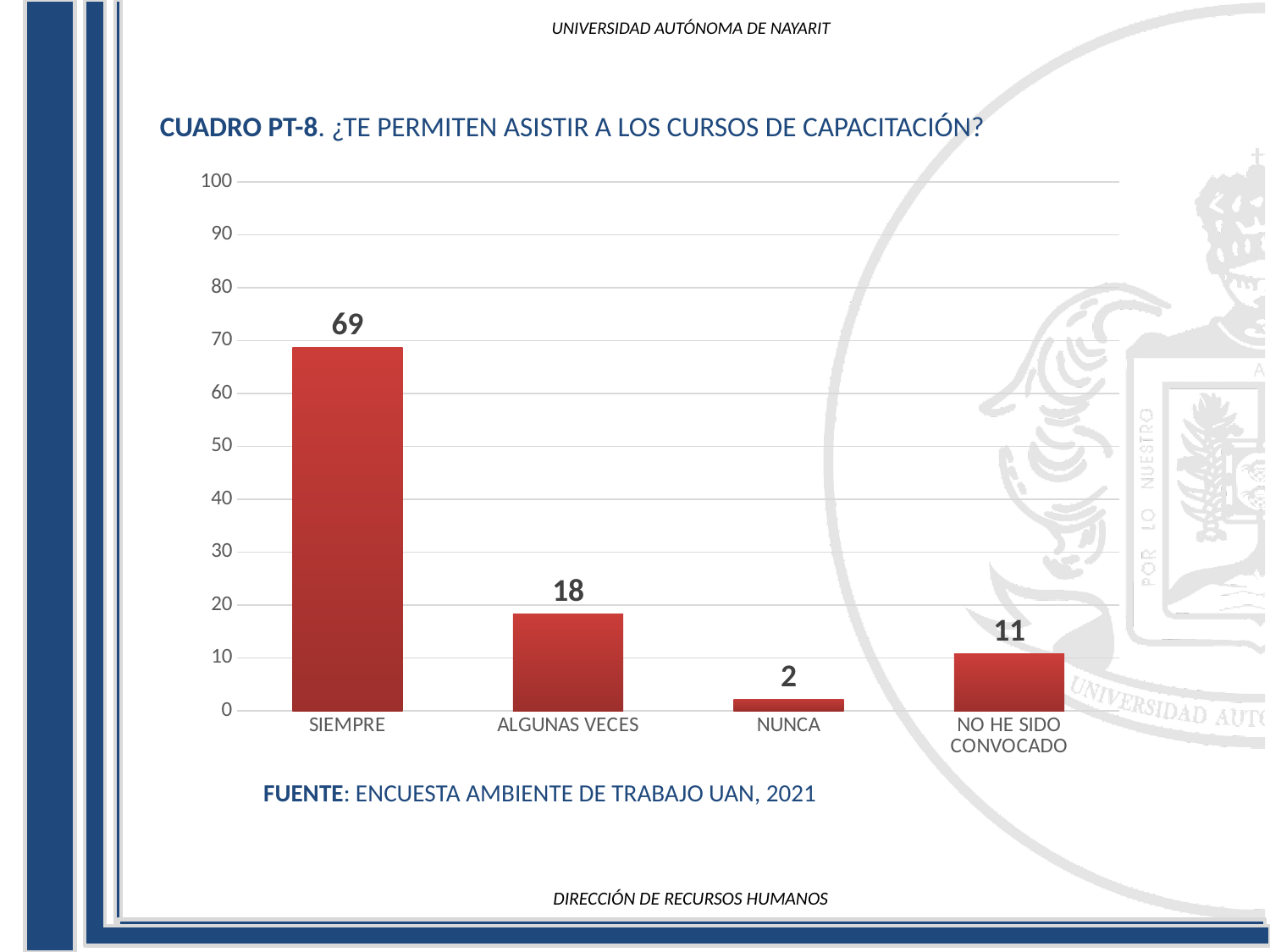
How many categories are shown on the x axis? 4 What is the value for NO HE SIDO CONVOCADO? 11 What is the difference between the values for SIEMPRE and ALGUNAS VECES? 51 Which is larger, the value for NO HE SIDO CONVOCADO or the value for NUNCA? NO HE SIDO CONVOCADO Which category has the highest value? SIEMPRE What is the value for NUNCA? 2 Is the value for SIEMPRE greater or less than 60? greater What is the difference between the values for ALGUNAS VECES and NO HE SIDO CONVOCADO? 7 What is the value for SIEMPRE? 69 What kind of chart is shown on the slide? bar chart What is the value for ALGUNAS VECES? 18 Which category has the lowest value? NUNCA